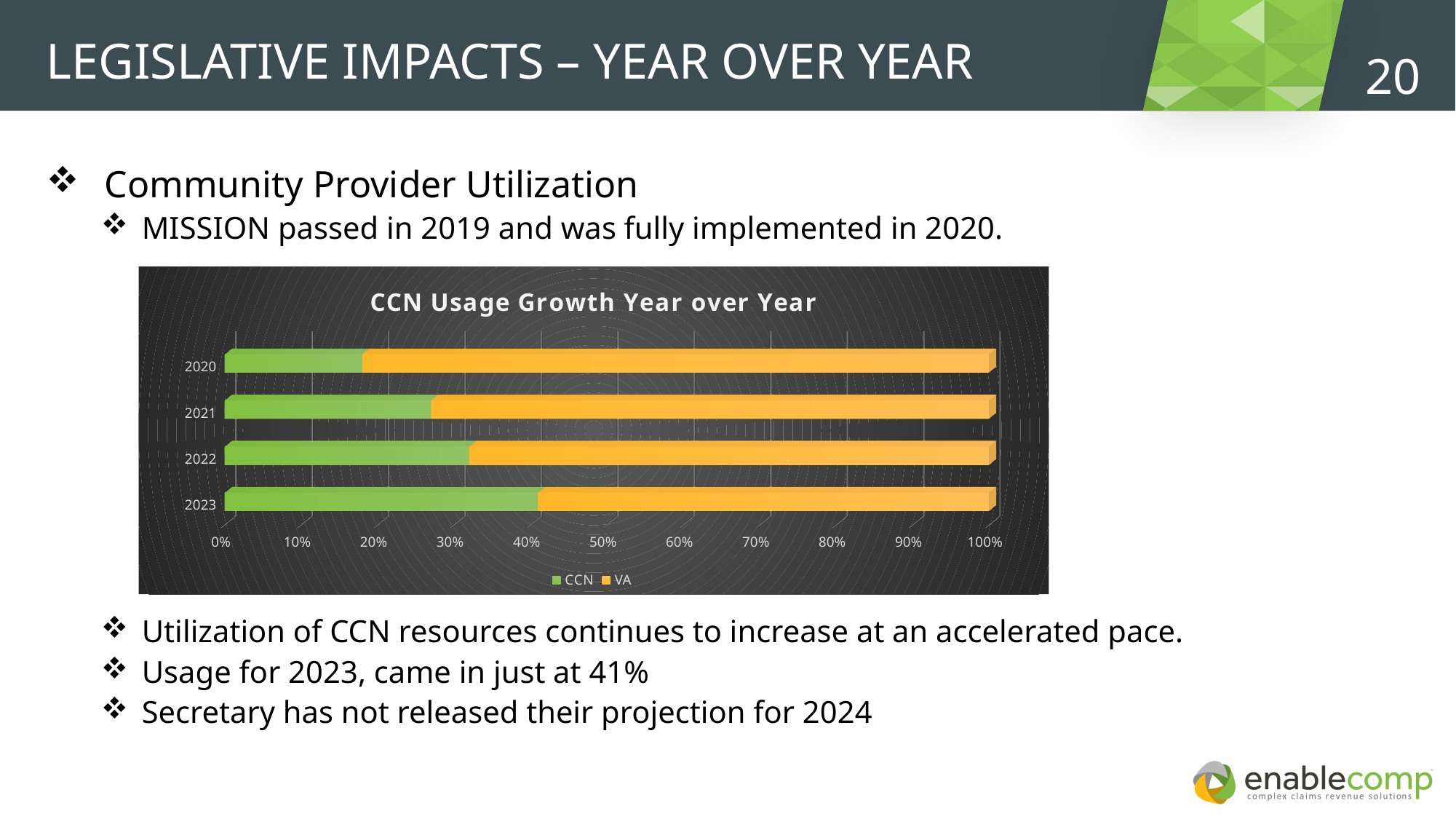
Is the CCN share for 2020 greater or less than 20%? less How many series does the chart's legend list? 2 Is the CCN share for 2023 greater or less than 30%? greater Which year has the lowest CCN share? 2020 How many years are plotted on the chart? 4 Is the CCN share for 2022 greater or less than 30%? greater Does the CCN share rise or fall from 2020 to 2023? rise What is the title of the chart? CCN Usage Growth Year over Year What kind of chart is shown on the slide? Stacked bar chart Which is larger, the CCN share in 2022 or in 2021? 2022 Which year has the highest CCN share? 2023